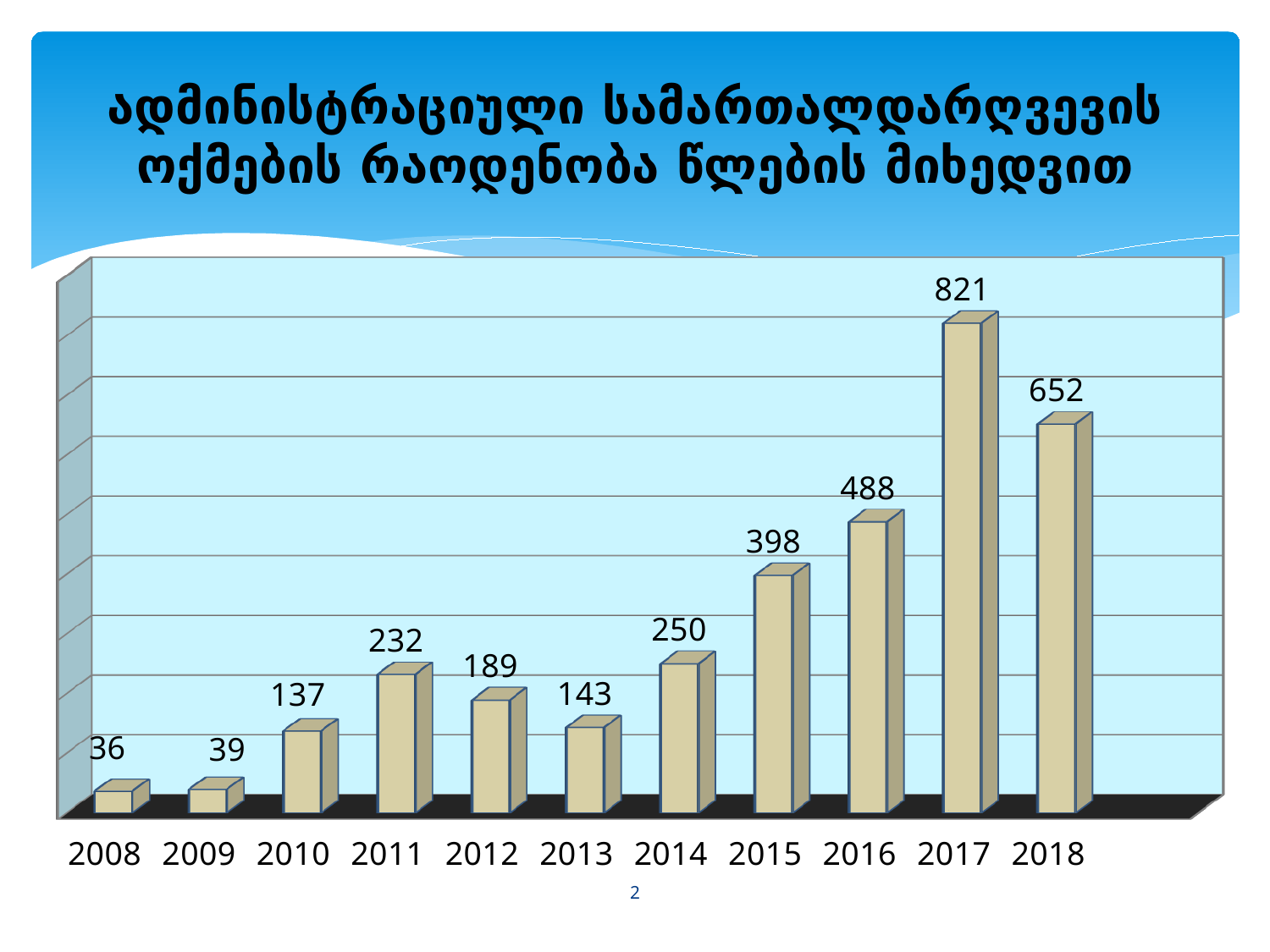
What is the value for 2014? 250 What kind of chart is shown on the slide? Bar chart Which year has the lowest value? 2008 Which is larger, the value for 2011 or the value for 2012? 2011 What is the difference between the values for 2016 and 2015? 90 Do the values generally rise or fall from 2008 to 2017? Rise Which year has the highest value? 2017 What is the value for 2017? 821 What is the difference between the values for 2017 and 2018? 169 How many years are shown on the x axis? 11 What is the value for 2010? 137 Which is larger, the value for 2013 or the value for 2014? 2014